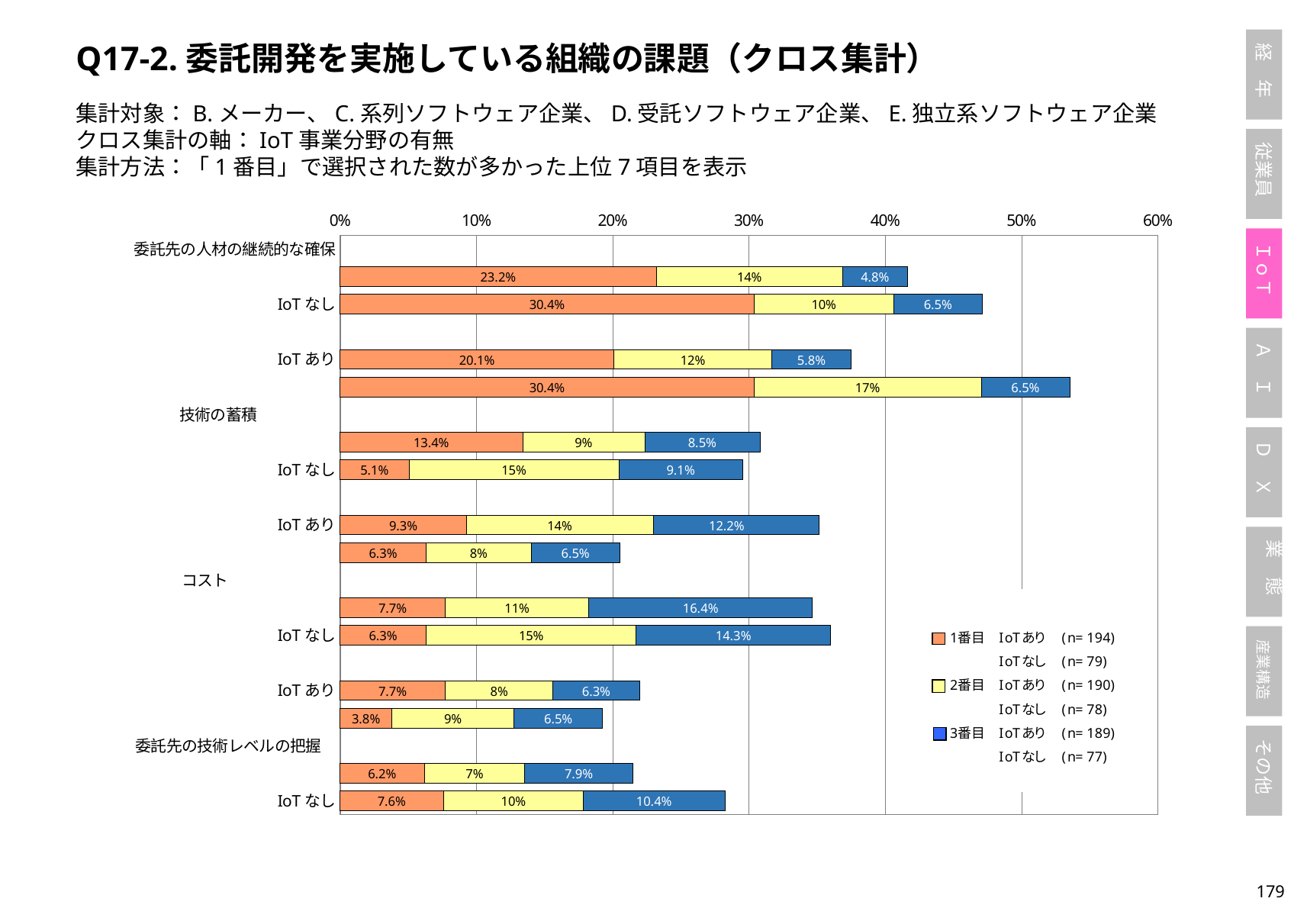
Is the total length of the bar with segments 30.4%, 17% and 6.5% greater or less than 50%? greater How many stacked bars are plotted in the chart? 14 How many series does the chart legend list? 3 What is the smallest 1番目 value shown on any bar in the chart? 3.8% What is the total of the bottom bar (7.6%, 10%, 10.4%)? 28% What is the largest 3番目 value shown on any bar in the chart? 16.4% What is the 1番目 value of the topmost bar in the chart? 23.2% What kind of chart is shown on the slide? bar chart What is the total of the topmost bar (1番目 + 2番目 + 3番目)? 42% In the topmost bar, what is the difference between the 1番目 value (23.2%) and the 3番目 value (4.8%)? 18.4 percentage points What is the 3番目 value of the bottom bar in the chart? 10.4% What is the 2番目 value of the topmost bar in the chart? 14%